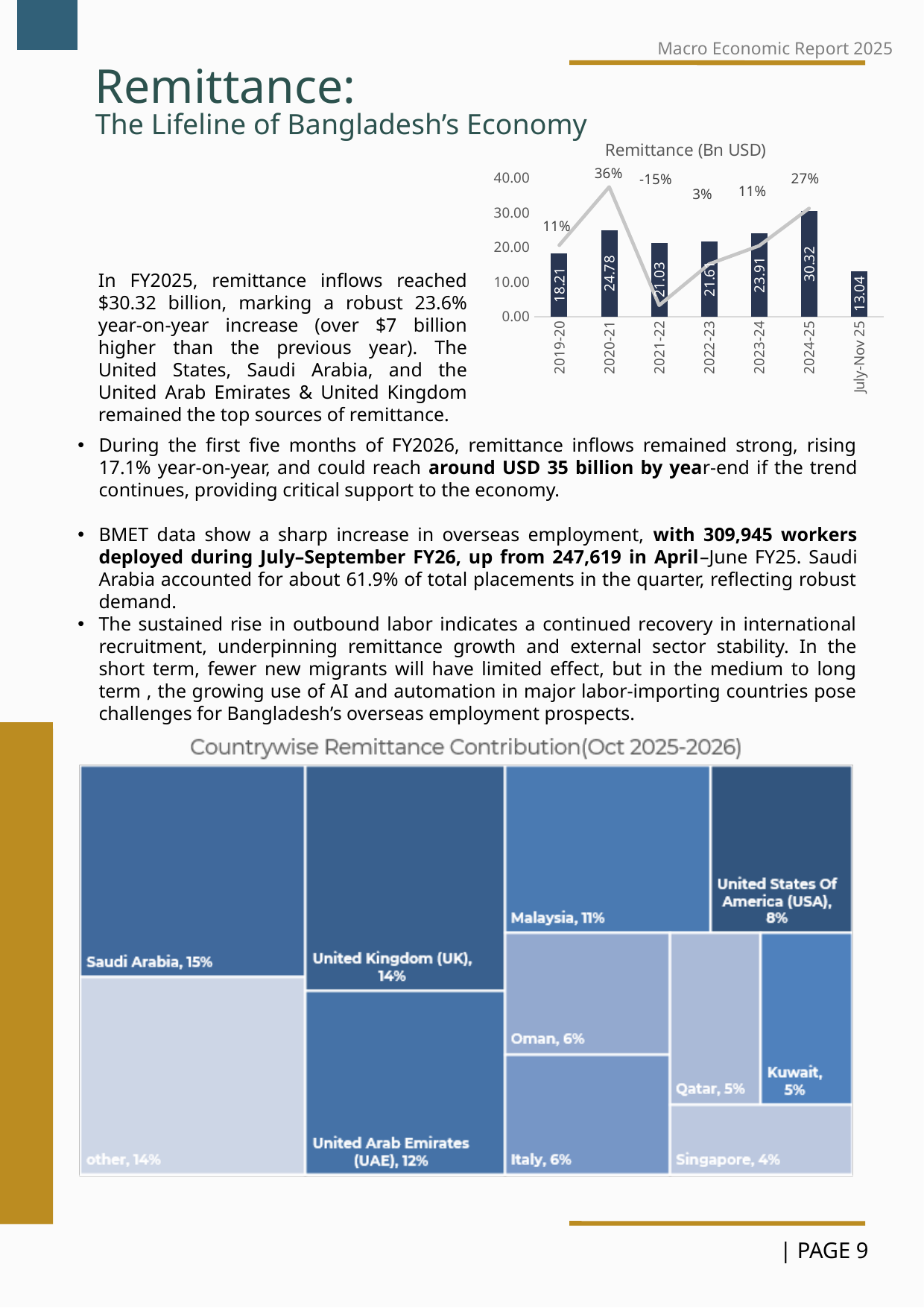
In the 'Remittance (Bn USD)' chart, what is the difference between the 2024-25 and 2023-24 remittance values? 6.41 In the 'Countrywise Remittance Contribution(Oct 2025-2026)' chart, which named country has the smallest share? Singapore In the 'Remittance (Bn USD)' chart, what is the remittance value for 2019-20? 18.21 In the 'Countrywise Remittance Contribution(Oct 2025-2026)' chart, which is larger, the share for Malaysia or the share for the United States of America (USA)? Malaysia In the 'Remittance (Bn USD)' chart, which fiscal year has the highest remittance bar? 2024-25 In the 'Remittance (Bn USD)' chart, which period has the lowest bar? July-Nov 25 In the 'Countrywise Remittance Contribution(Oct 2025-2026)' chart, what is the difference between the shares of the United Kingdom (UK) and the United Arab Emirates (UAE)? 2% In the 'Remittance (Bn USD)' chart, how many periods are shown on the x axis? 7 In the 'Remittance (Bn USD)' chart, which year has the highest growth percentage on the line? 2020-21 In the 'Countrywise Remittance Contribution(Oct 2025-2026)' chart, what share is attributed to Saudi Arabia? 15% In the 'Remittance (Bn USD)' chart, what growth percentage is shown for 2021-22? -15% In the 'Remittance (Bn USD)' chart, what is the remittance value for 2024-25? 30.32